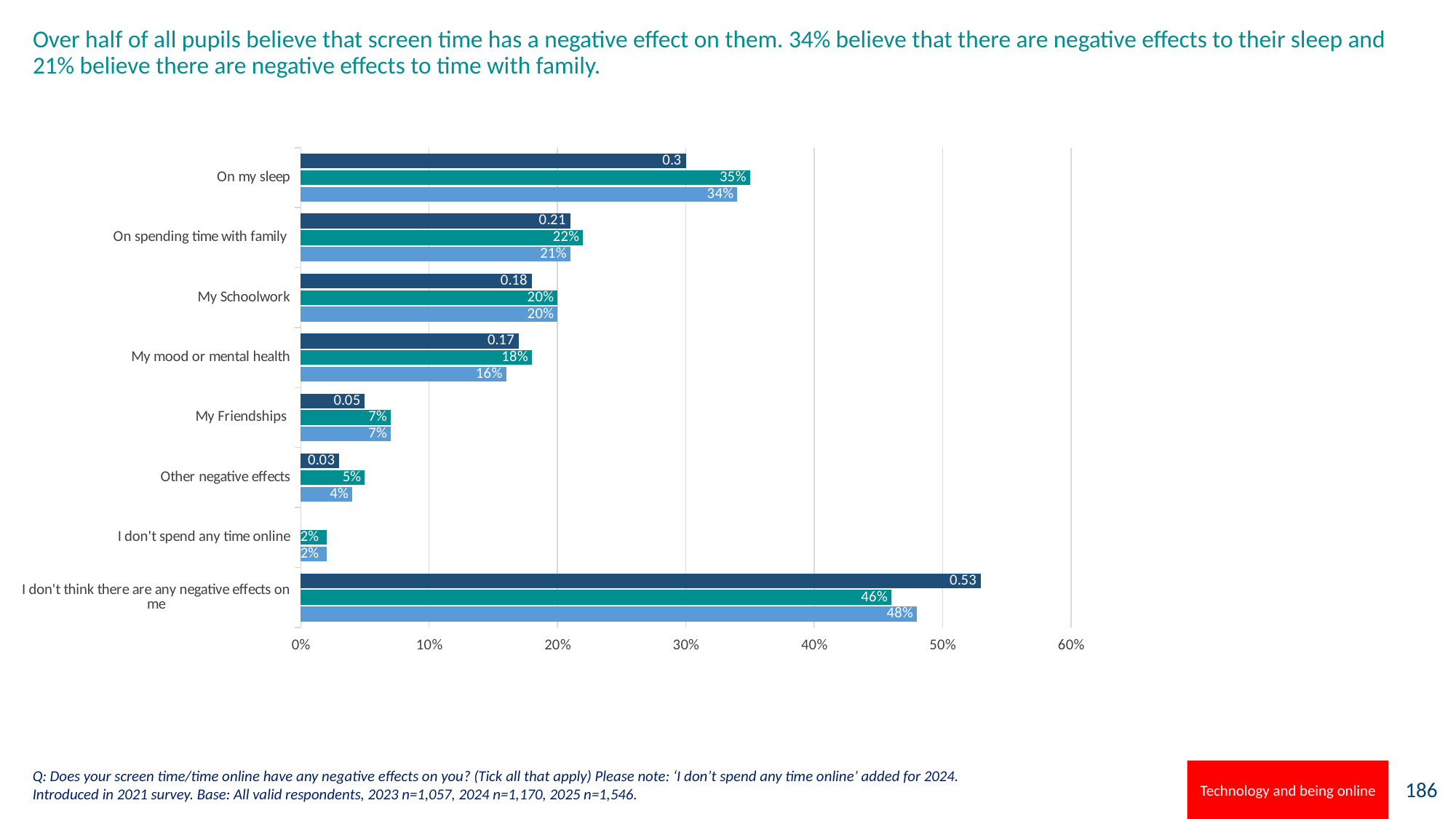
For "On spending time with family", which is larger: the teal bar or the light blue bar? The teal bar What value is labelled on the dark navy (top) bar for "I don't think there are any negative effects on me"? 0.53 What value is shown on the light blue (bottom) bar for "My mood or mental health"? 16% What value is shown on the teal (middle) bar for "On my sleep"? 35% What kind of chart is shown on the slide? Bar chart For "My mood or mental health", what is the difference between the teal bar and the light blue bar? 2 percentage points What value is labelled on the dark navy (top) bar for "On my sleep"? 0.3 How many categories are shown on the vertical axis of the chart? 8 Among the light blue (bottom) bars, which category has the highest value? I don't think there are any negative effects on me For "I don't think there are any negative effects on me", what is the difference between the light blue bar and the teal bar? 2 percentage points Is the light blue bar for "On my sleep" greater or less than 30%? greater Among the teal (middle) bars, which category has the lowest value? I don't spend any time online